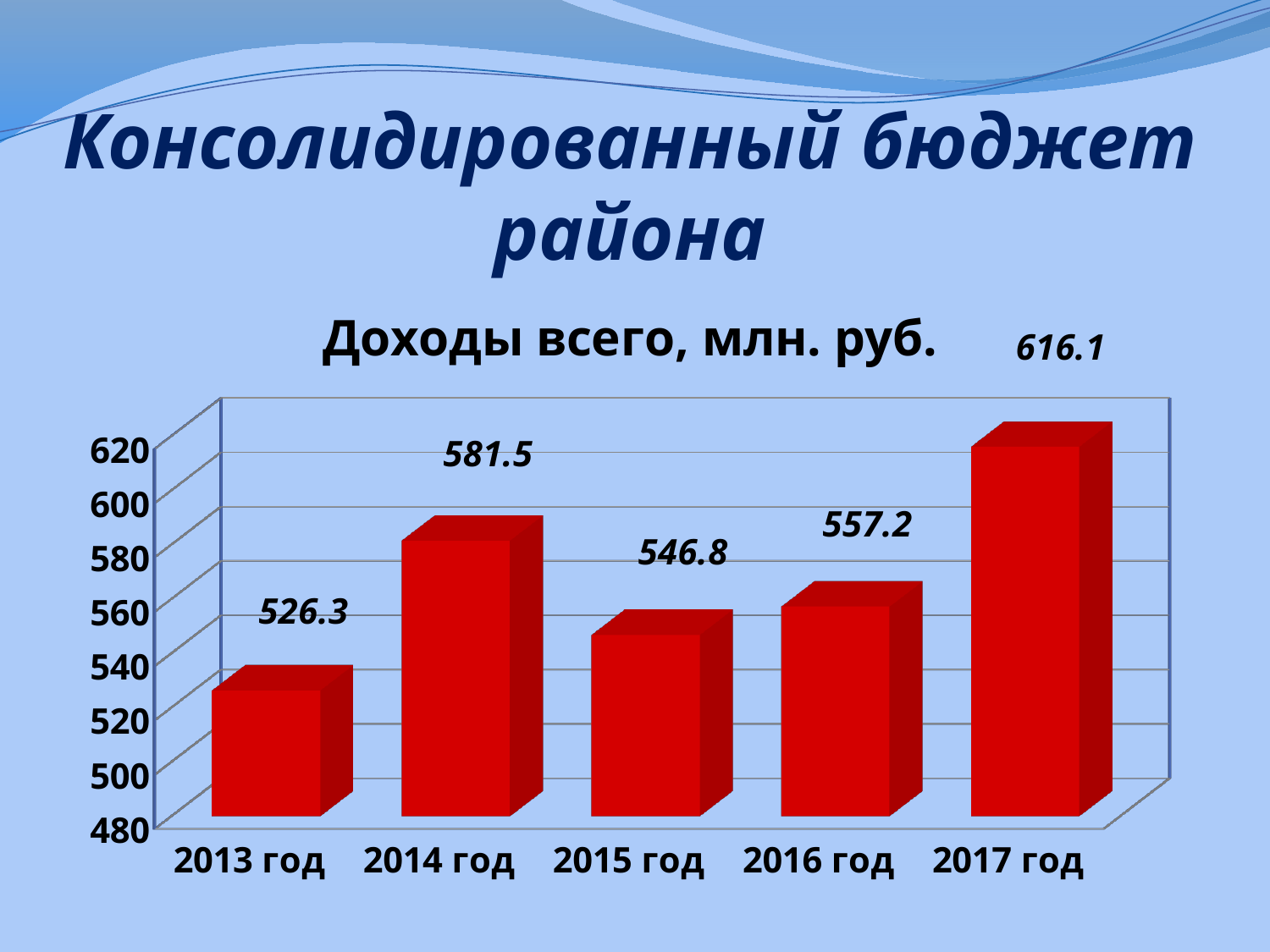
Is the value for 2016 год greater or less than 540? greater Which year has the highest value? 2017 год How many years are shown on the chart? 5 What is the value for 2013 год? 526.3 What is the difference between the values for 2017 год and 2013 год? 89.8 Which year has the lowest value? 2013 год What is the value for 2015 год? 546.8 Which is larger, the value for 2014 год or the value for 2016 год? 2014 год What is the value for 2017 год? 616.1 What is the title of the chart? Доходы всего, млн. руб. What is the difference between the values for 2014 год and 2015 год? 34.7 What kind of chart is shown on the slide? bar chart